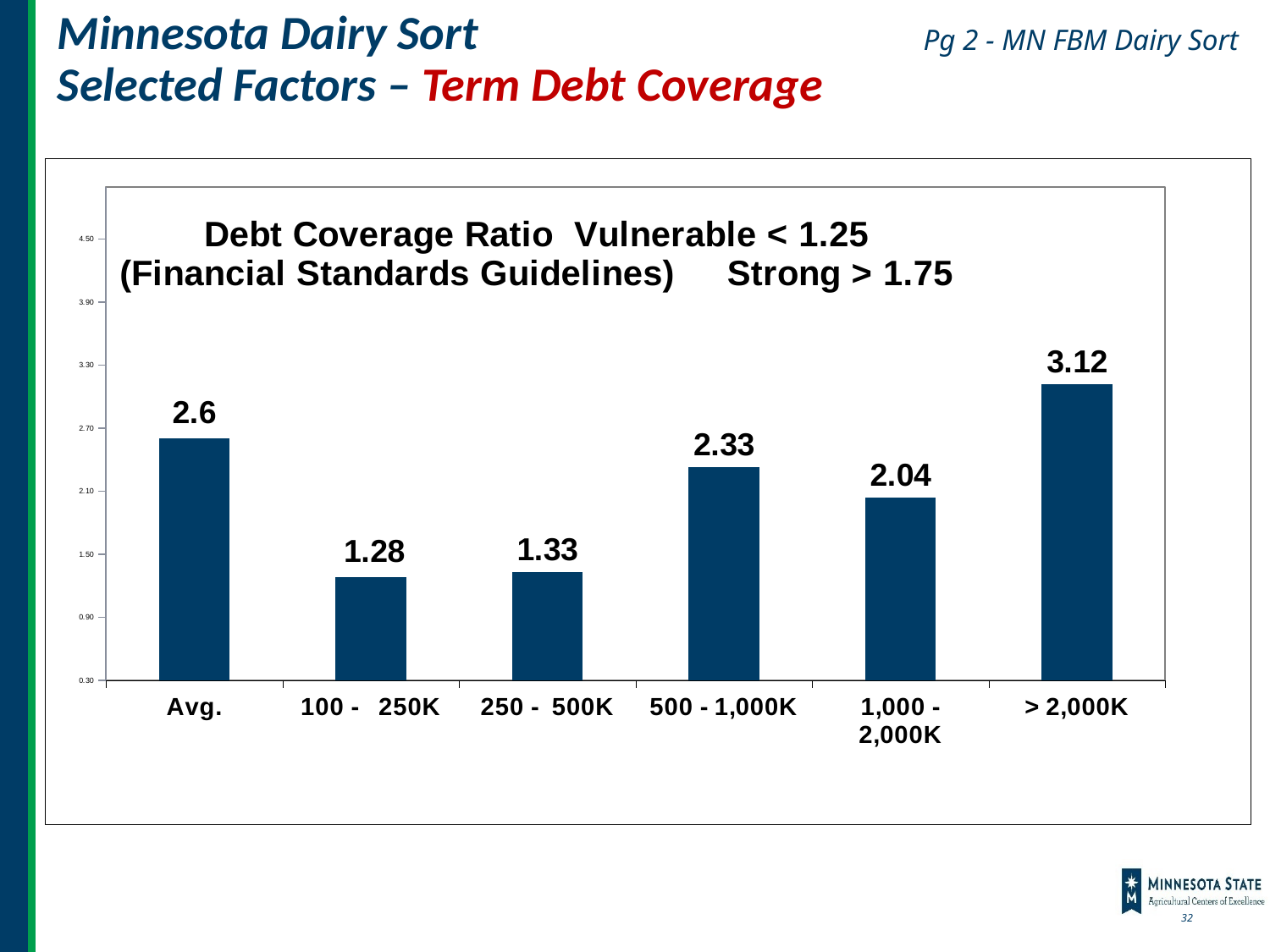
What kind of chart is shown on the slide? Bar chart Which has a larger debt coverage ratio, 250 - 500K or 1,000 - 2,000K? 1,000 - 2,000K What is the debt coverage ratio for the Avg. category? 2.6 Which category has the highest debt coverage ratio? > 2,000K What is the debt coverage ratio for the > 2,000K category? 3.12 According to the chart title, below what debt coverage ratio is a farm considered vulnerable? 1.25 Is the value for 100 - 250K greater or less than 1.50? less How many categories are shown on the x axis of the chart? 6 Which category has the lowest debt coverage ratio? 100 - 250K What is the debt coverage ratio for the 500 - 1,000K category? 2.33 What is the difference between the debt coverage ratio for > 2,000K and for Avg.? 0.52 What is the difference between the debt coverage ratio for 500 - 1,000K and for 1,000 - 2,000K? 0.29